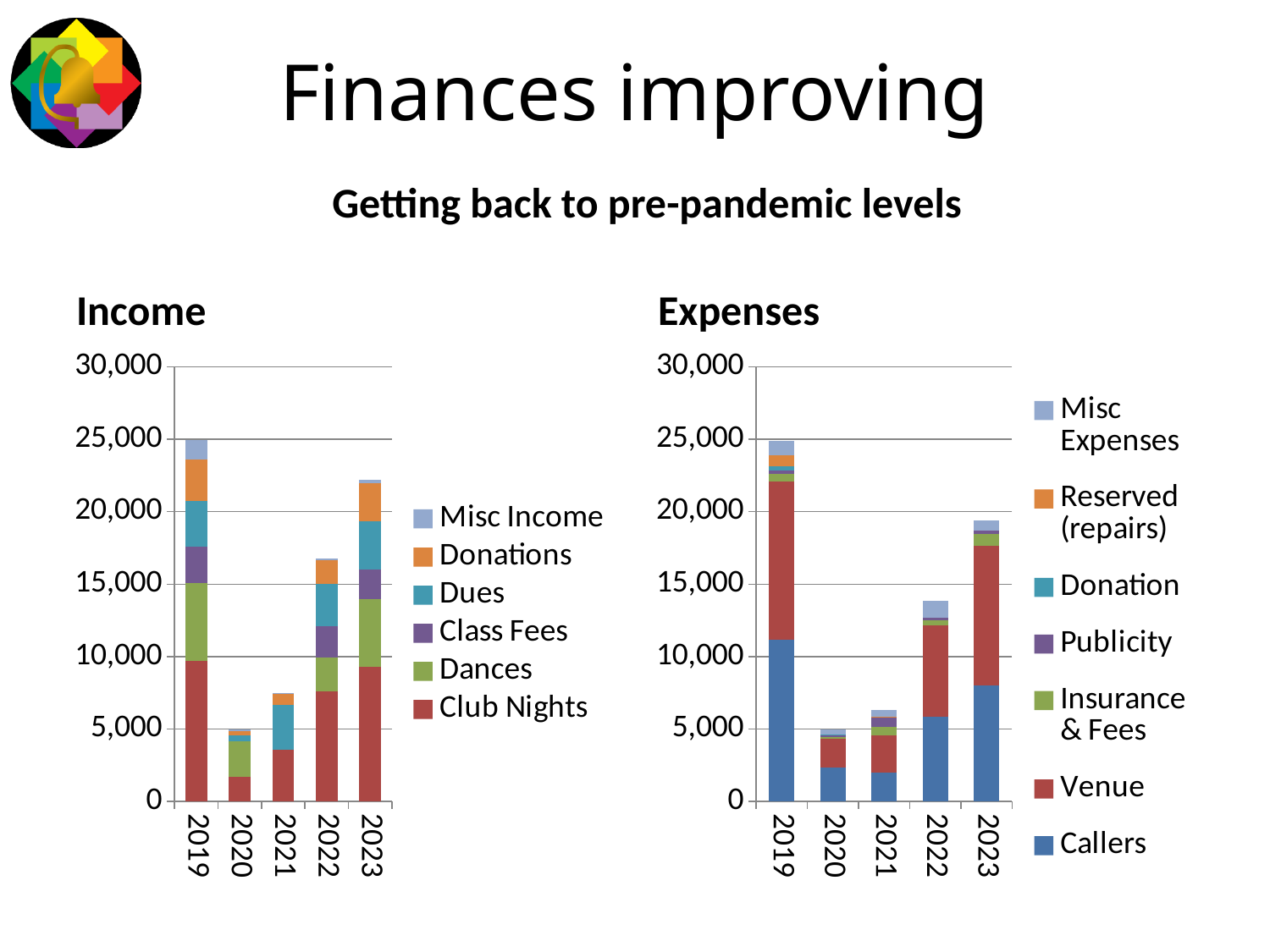
How many years are shown on the x axis of the Income chart? 5 In the Income chart, which year has the highest total income? 2019 What type of chart is the Income chart? stacked bar chart In the Income chart, do total income values rise or fall from 2020 to 2023? rise In the Income chart, which year has the lowest total income? 2020 In the Expenses chart, is the total expenses for 2023 greater or less than 20,000? less How many series does the legend of the Income chart list? 6 In the Expenses chart, is the total expenses for 2022 greater or less than 10,000? greater In the Expenses chart, which year has the lowest total expenses? 2020 How many series does the legend of the Expenses chart list? 7 Which series is shown in blue at the bottom of each bar in the Expenses chart? Callers In the Income chart, is the total income for 2022 greater or less than 15,000? greater